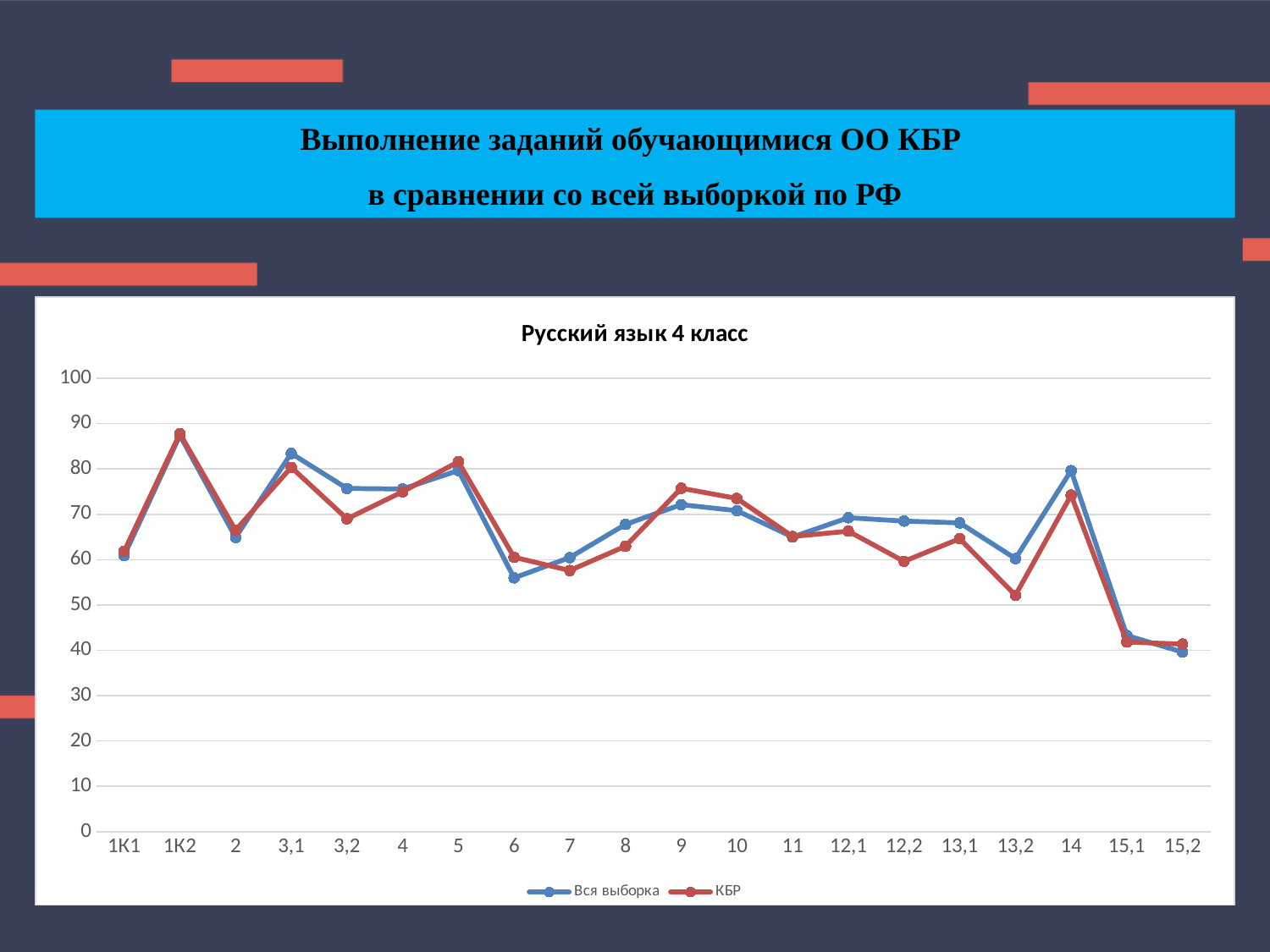
How many series does the legend list? 2 Is the value for КБР at 13,2 greater or less than 60? less Between categories 14 and 15,1, do the values for КБР rise or fall? fall Which series is drawn in red? КБР What is the title of the chart? Русский язык 4 класс What kind of chart is shown on the slide? line chart At category 12,2, which series has the larger value, Вся выборка or КБР? Вся выборка How many categories are shown along the x axis? 20 For which category is the value for Вся выборка highest? 1К2 For which category is the value for КБР highest? 1К2 Is the value for Вся выборка at 14 greater or less than 70? greater Is the value for Вся выборка at 15,2 greater or less than 50? less